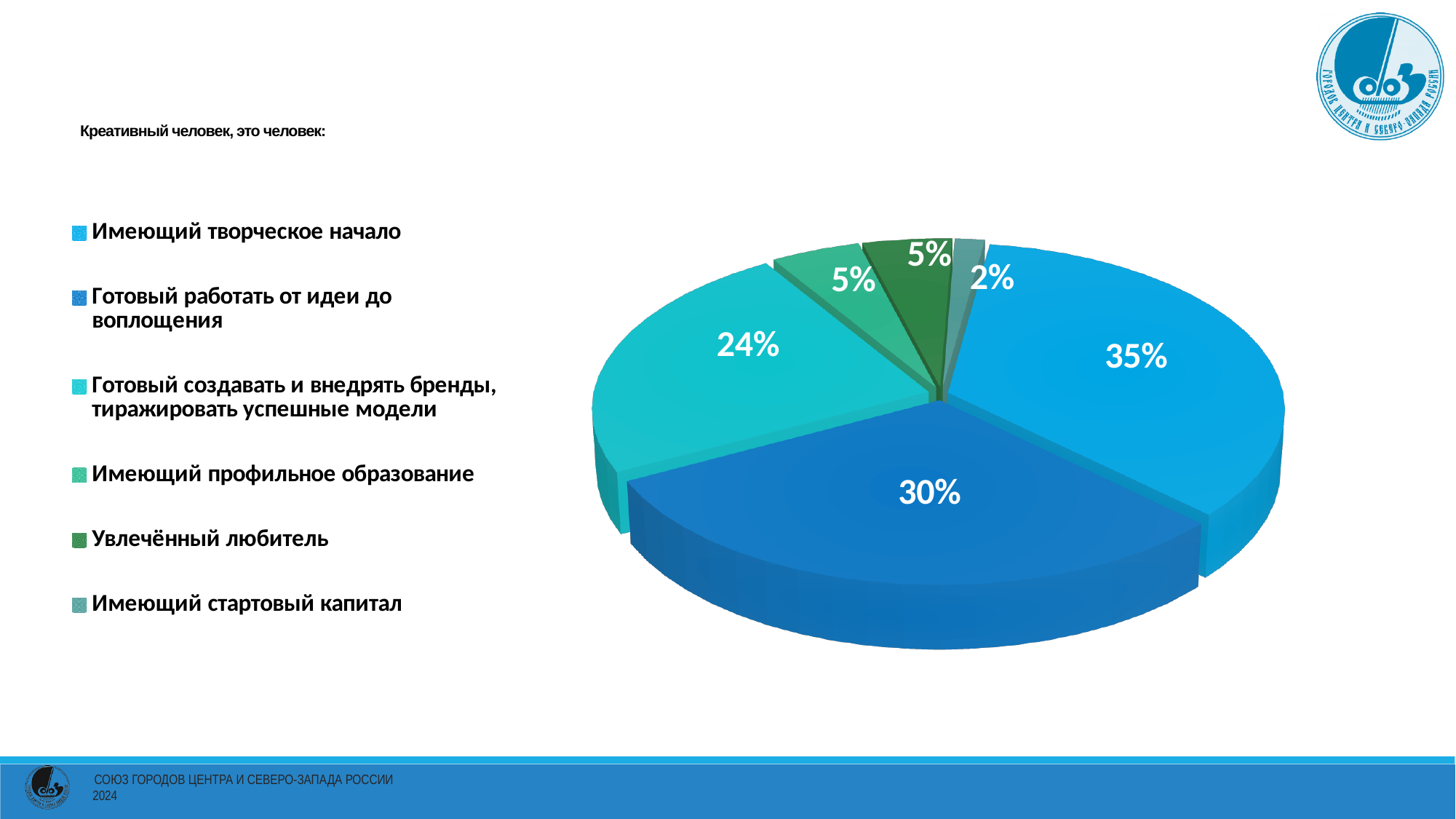
Which category has the largest slice of the pie? Имеющий творческое начало What is the title text above the legend of the chart? Креативный человек, это человек: What is the difference in percentage points between "Имеющий творческое начало" and "Готовый работать от идеи до воплощения"? 5 percentage points Which category has the smallest slice of the pie? Имеющий стартовый капитал What share of the pie does "Готовый создавать и внедрять бренды, тиражировать успешные модели" have? 24% What share of the pie does "Увлечённый любитель" have? 5% What share of the pie does "Имеющий творческое начало" have? 35% What share of the pie does "Готовый работать от идеи до воплощения" have? 30% What kind of chart is shown on the slide? Pie chart How many categories does the legend of the pie chart list? 6 What share of the pie does "Имеющий стартовый капитал" have? 2% Which is larger: the slice for "Готовый работать от идеи до воплощения" or the slice for "Готовый создавать и внедрять бренды, тиражировать успешные модели"? Готовый работать от идеи до воплощения